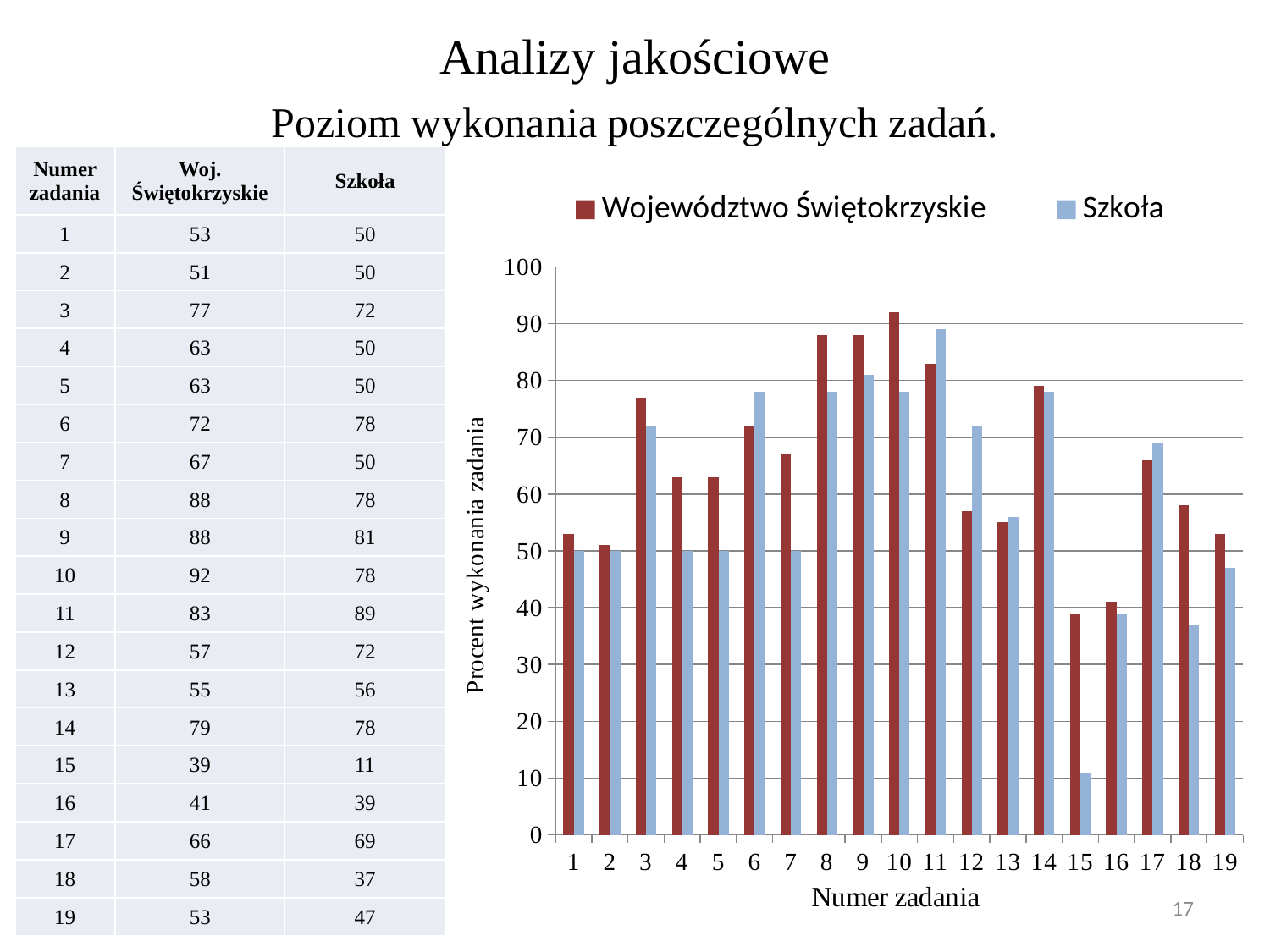
What kind of chart is shown on the slide? bar chart For which task number is the Szkoła bar the highest? 11 How many task numbers (categories) are shown on the x axis of the chart? 19 What is the Województwo Świętokrzyskie value for task 10? 92 What is the title of the vertical axis of the chart? Procent wykonania zadania What is the difference between the Województwo Świętokrzyskie and Szkoła values for task 15? 28 For task 12, which series has the larger value, Województwo Świętokrzyskie or Szkoła? Szkoła For which task number is the Szkoła bar the lowest? 15 For which task number is the Województwo Świętokrzyskie bar the highest? 10 How many series does the chart legend list? 2 What is the Szkoła value for task 11? 89 Is the Szkoła value for task 18 greater or less than 40? less